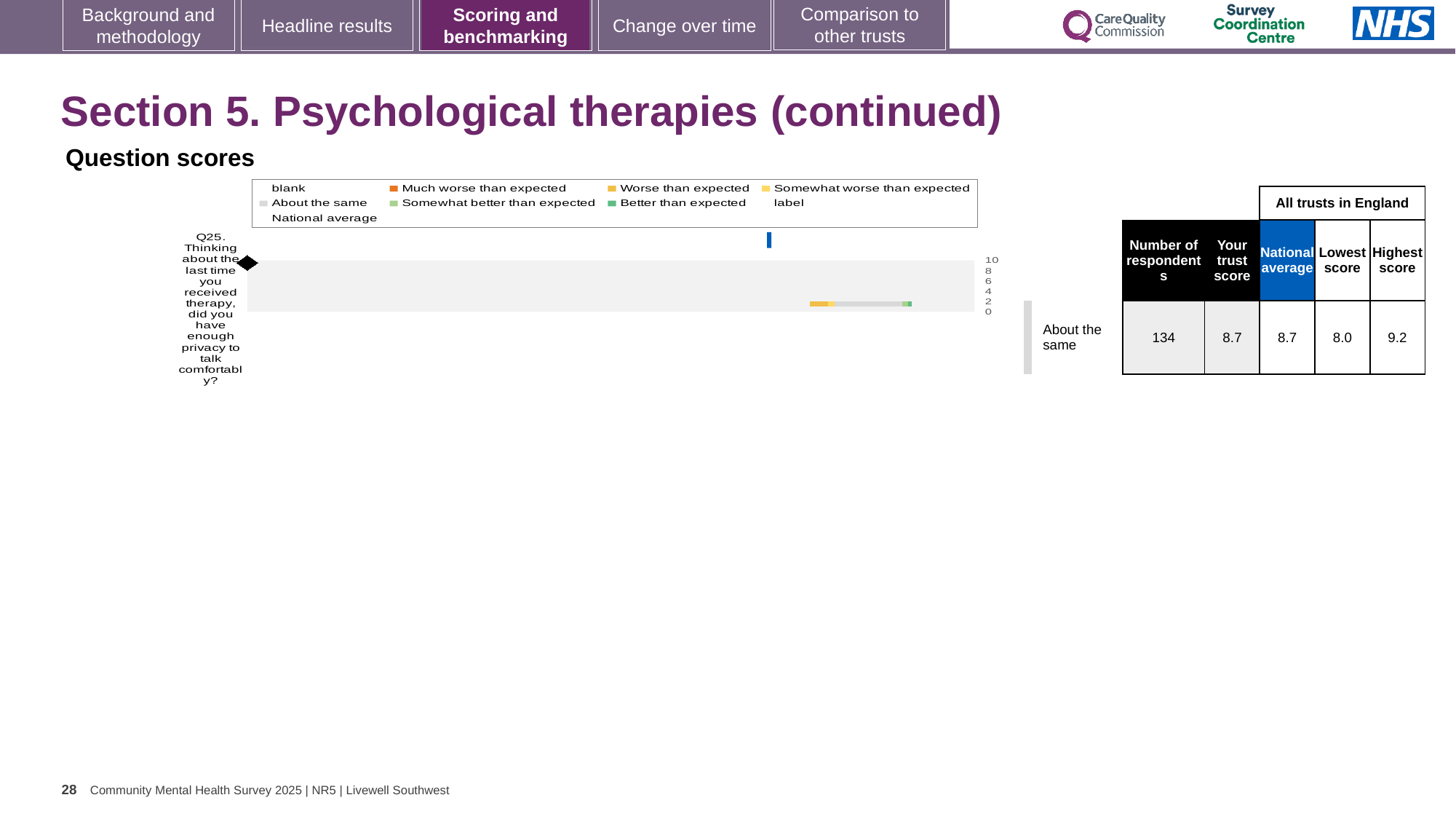
What kind of chart is shown under 'Question scores'? bar chart What is the lowest score among all trusts in England for Q25? 8.0 What is 'Your trust score' for Q25? 8.7 How many questions are plotted in the Question scores chart? 1 What is the number of respondents for Q25? 134 Which question is plotted in the Question scores chart? Q25. Thinking about the last time you received therapy, did you have enough privacy to talk comfortably? What is the national average score for Q25? 8.7 What is the highest score among all trusts in England for Q25? 9.2 What is the benchmark category shown for Q25 next to the chart? About the same What is the difference between the highest score and the lowest score for Q25? 1.2 Is the trust score for Q25 greater or less than the lowest score of 8.0? greater What is the maximum value shown on the chart's axis? 10